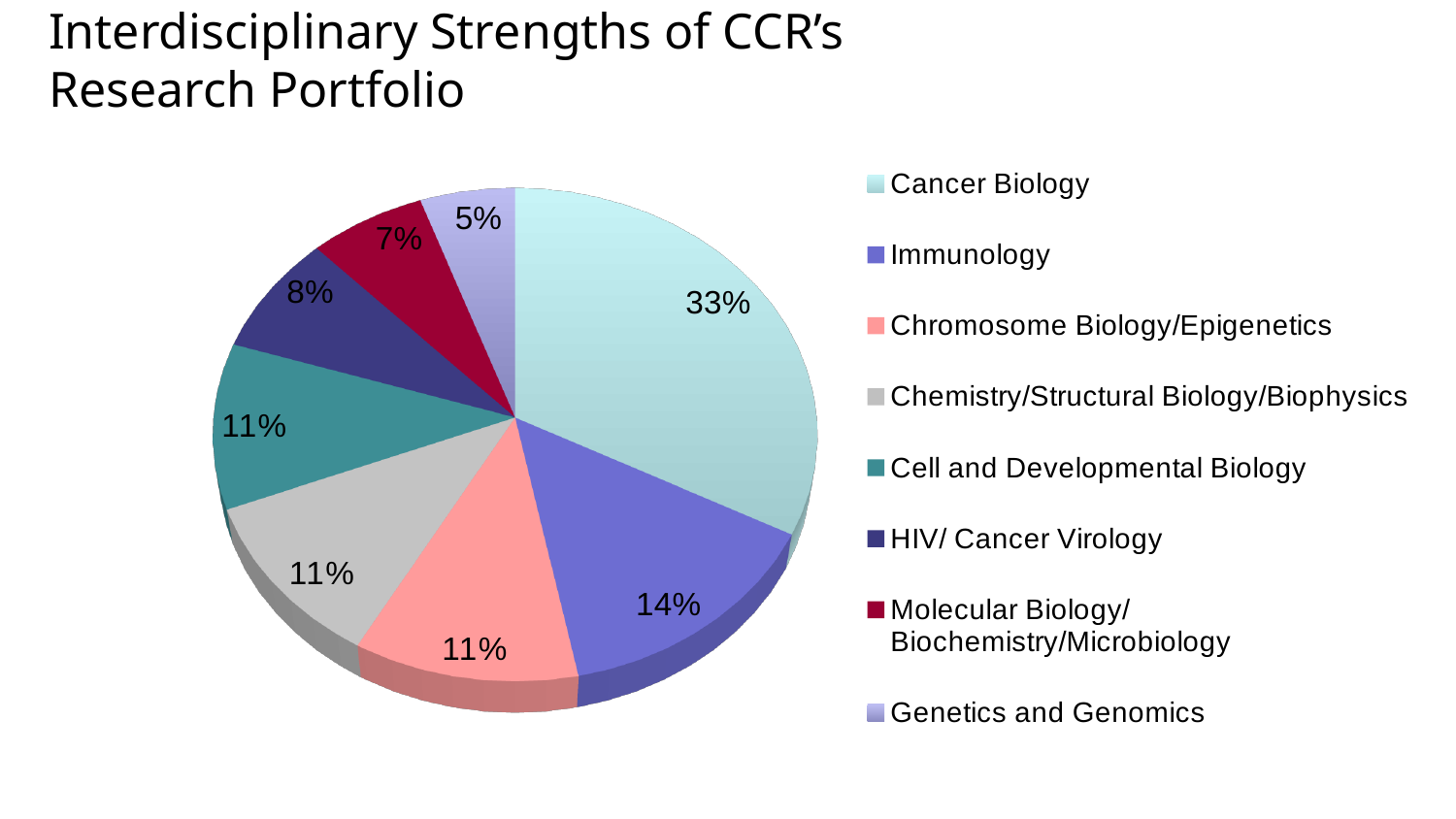
Which category has the largest slice of the pie? Cancer Biology What share of the pie does HIV/ Cancer Virology represent? 8% Which is larger, the share for Immunology or the share for HIV/ Cancer Virology? Immunology What share of the pie does Genetics and Genomics represent? 5% What is the title of the slide? Interdisciplinary Strengths of CCR's Research Portfolio What share of the pie does Immunology represent? 14% What kind of chart is shown on the slide? Pie chart Which category has the smallest slice of the pie? Genetics and Genomics What is the difference in percentage points between Cancer Biology and Immunology? 19 How many categories does the pie chart show? 8